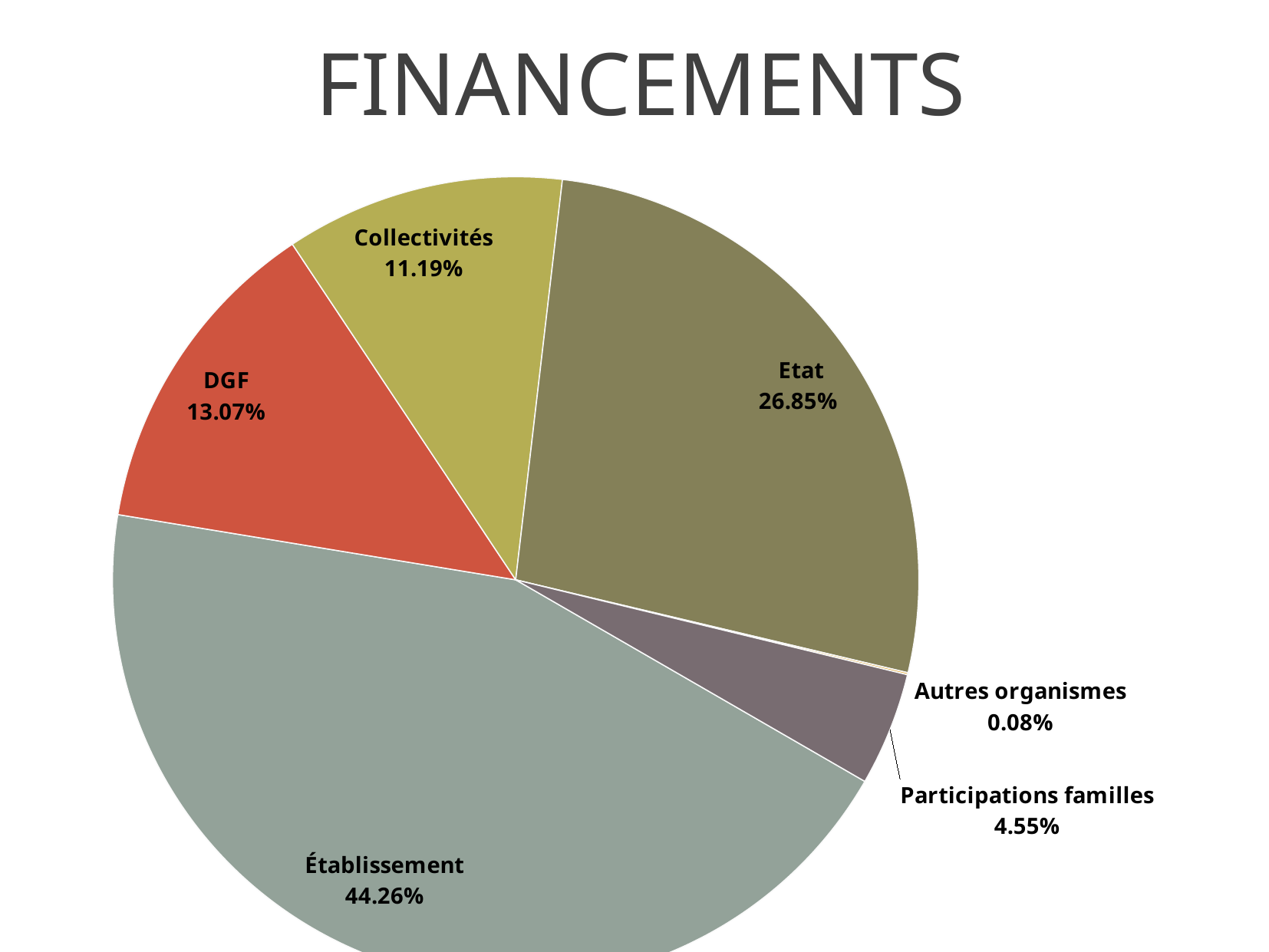
What is the value shown for Etat? 26.85% Which is larger, the share for Collectivités or the share for DGF? DGF What is the difference between the shares of Établissement and Etat? 17.41% What is the value shown for DGF? 13.07% What is the difference between the shares of Etat and DGF? 13.78% What is the title of the chart? FINANCEMENTS Which category has the largest slice of the pie? Établissement Which category has the smallest slice of the pie? Autres organismes What share does Établissement have in the pie? 44.26% How many slices does the pie chart have? 6 What is the value shown for Participations familles? 4.55% What type of chart is shown on the slide? pie chart